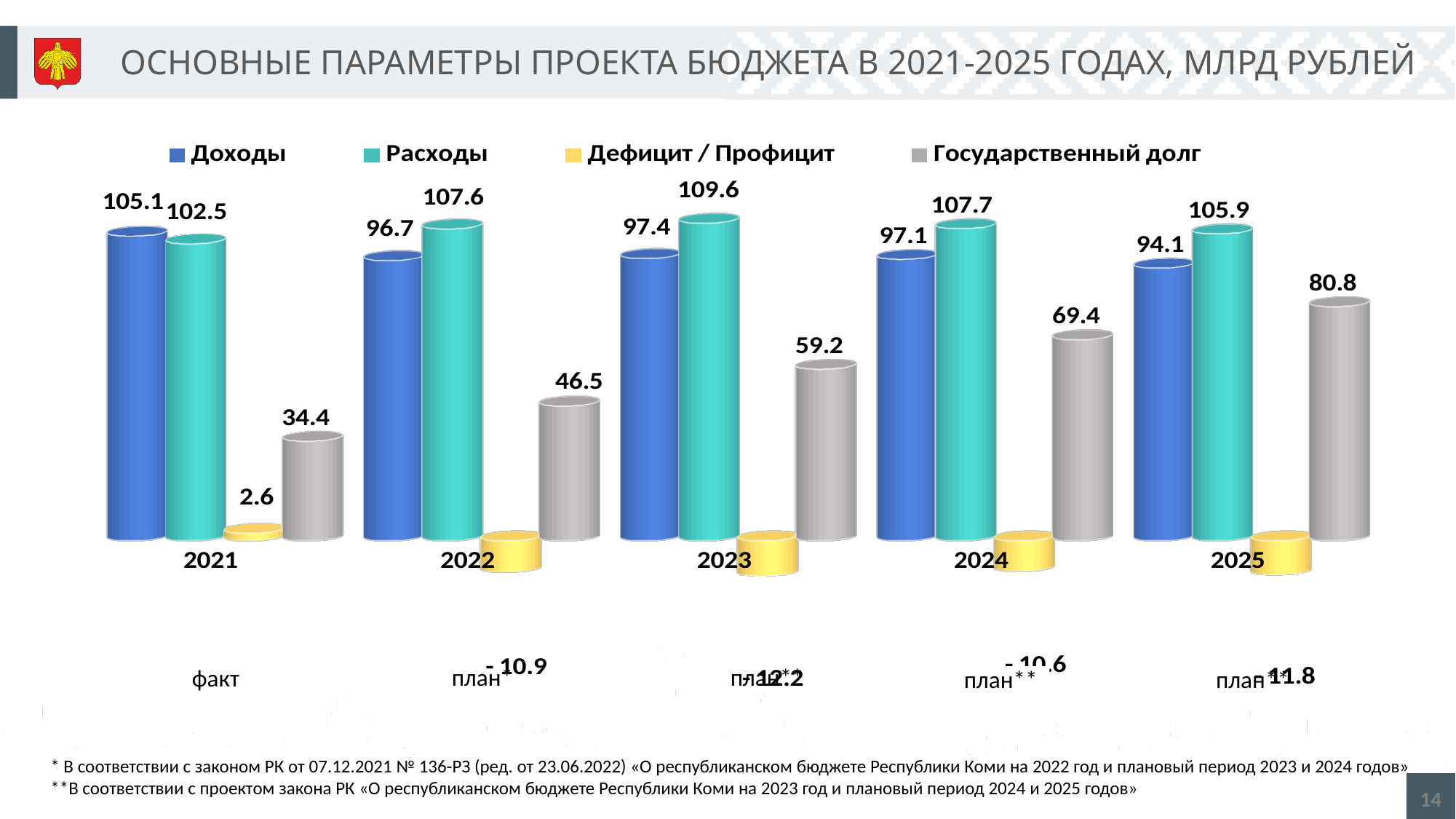
What is the value of Доходы for 2021? 105.1 How many series does the legend list? 4 What is the value of Государственный долг for 2025? 80.8 What is the value of Расходы for 2023? 109.6 Which is larger in 2021, Доходы or Расходы? Доходы What is the difference between Расходы and Доходы in 2022? 10.9 What kind of chart is shown on the slide? Bar chart In which year is Доходы the lowest? 2025 What is the value of Дефицит / Профицит for 2022? - 10.9 Does Государственный долг rise or fall from 2021 to 2025? Rises How many years are shown on the x axis? 5 In which year is Государственный долг the highest? 2025